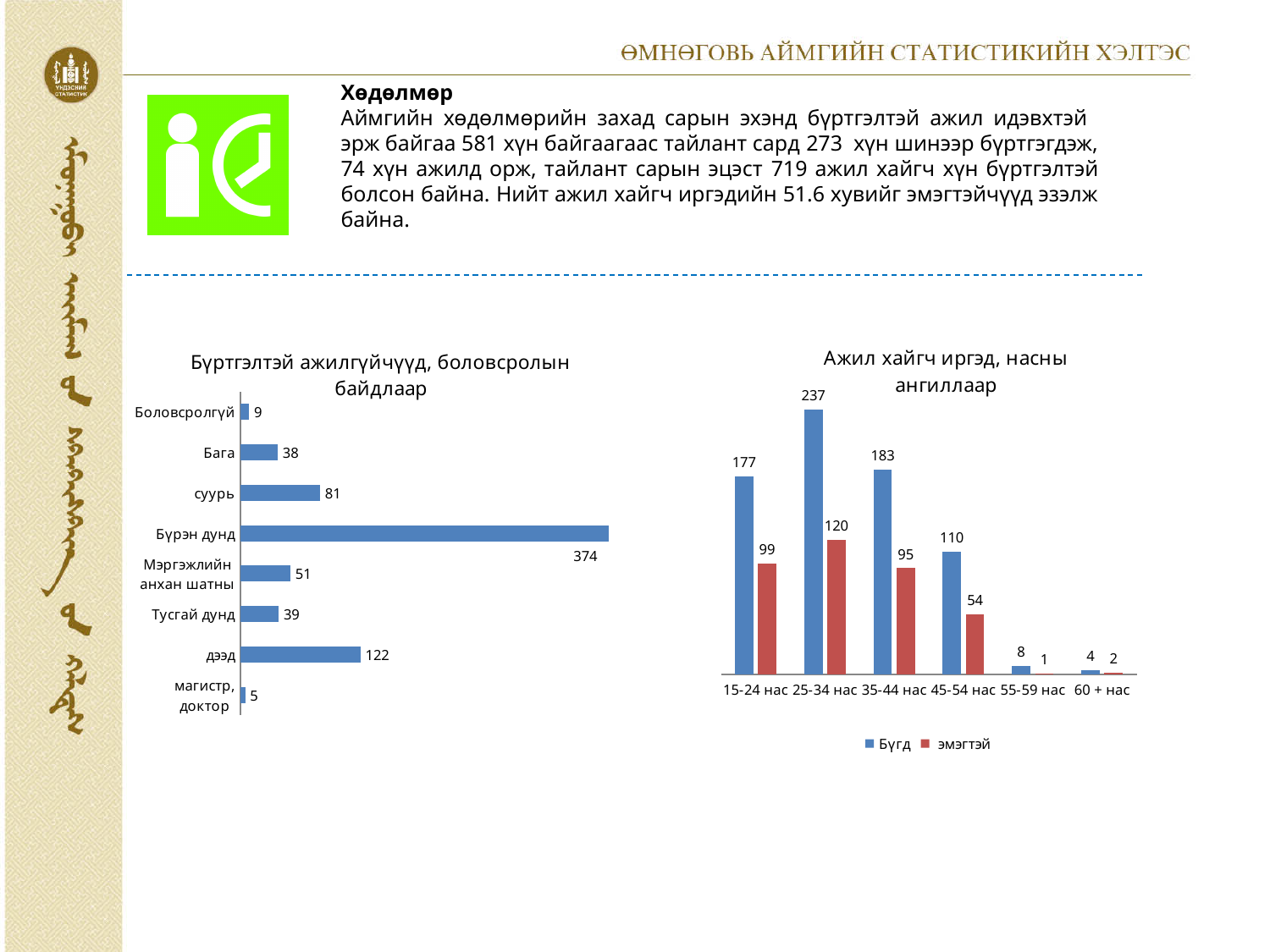
What kind of chart is 'Бүртгэлтэй ажилгүйчүүд, боловсролын байдлаар'? Bar chart In the chart 'Бүртгэлтэй ажилгүйчүүд, боловсролын байдлаар', what is the difference between 'суурь' and 'Бага'? 43 In the chart 'Ажил хайгч иргэд, насны ангиллаар', what is the difference between the 'Бүгд' and 'эмэгтэй' values for '15-24 нас'? 78 In the chart 'Ажил хайгч иргэд, насны ангиллаар', which age group has the highest 'Бүгд' value? 25-34 нас In the chart 'Бүртгэлтэй ажилгүйчүүд, боловсролын байдлаар', what is the value for 'Бүрэн дунд'? 374 In the chart 'Бүртгэлтэй ажилгүйчүүд, боловсролын байдлаар', what is the value for 'дээд'? 122 In the chart 'Бүртгэлтэй ажилгүйчүүд, боловсролын байдлаар', which category has the lowest value? магистр, доктор In the chart 'Ажил хайгч иргэд, насны ангиллаар', which is larger: the 'Бүгд' value for '35-44 нас' or for '45-54 нас'? 35-44 нас In the chart 'Ажил хайгч иргэд, насны ангиллаар', what is the 'Бүгд' value for '25-34 нас'? 237 In the chart 'Бүртгэлтэй ажилгүйчүүд, боловсролын байдлаар', how many categories are shown? 8 In the chart 'Ажил хайгч иргэд, насны ангиллаар', how many series does the legend list? 2 In the chart 'Ажил хайгч иргэд, насны ангиллаар', what is the 'эмэгтэй' value for '45-54 нас'? 54